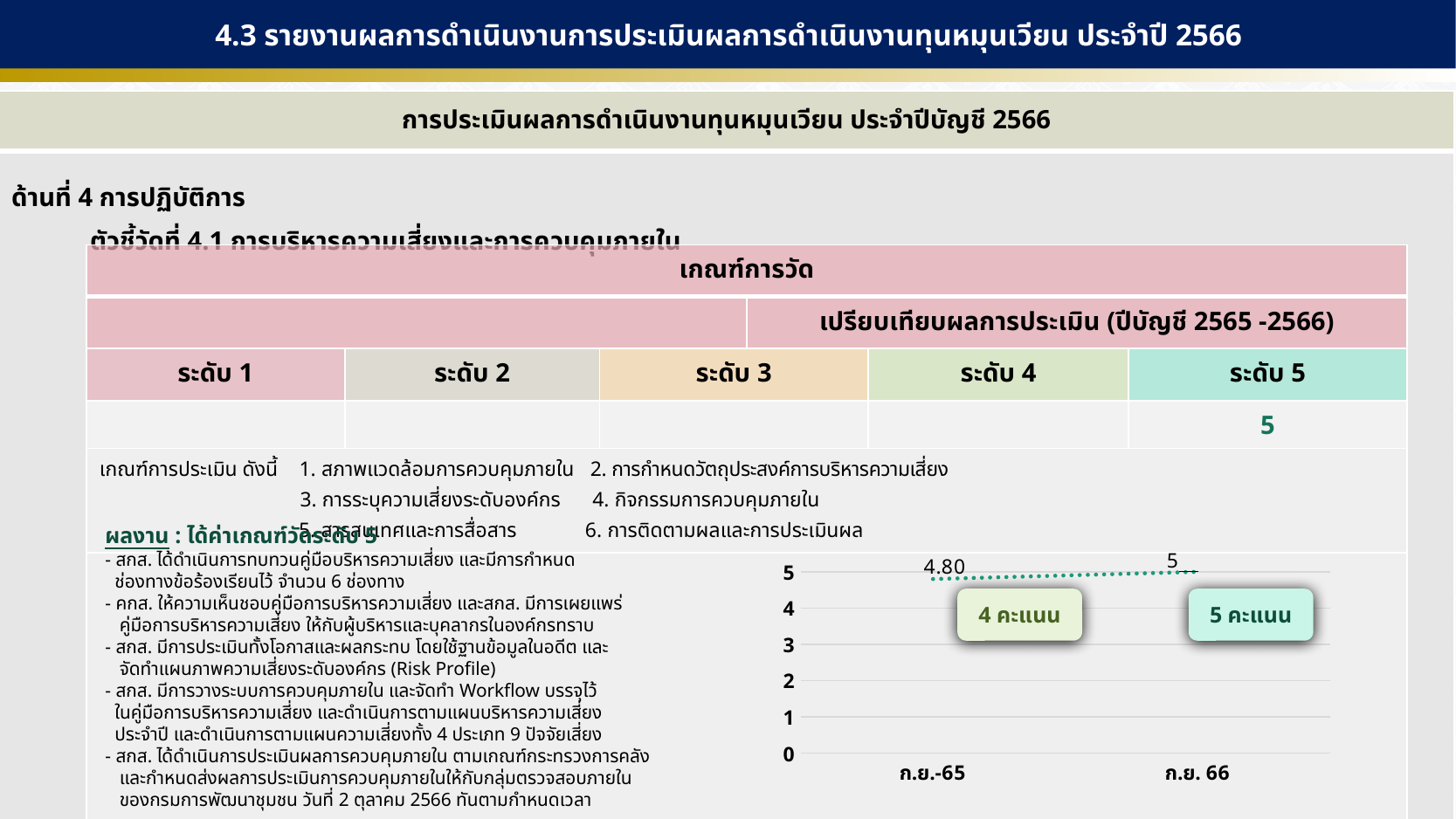
What is the difference between the values for ก.ย. 66 and ก.ย.-65? 0.20 Is the value for ก.ย.-65 greater or less than 4? greater What is the value plotted for ก.ย.-65? 4.80 What score is shown in the callout box above ก.ย. 66? 5 คะแนน What is the highest value shown on the chart's vertical axis? 5 What is the value plotted for ก.ย. 66? 5 Do the values rise or fall from ก.ย.-65 to ก.ย. 66? rise Which category has the lower value on the chart? ก.ย.-65 What kind of chart is shown on the slide? line chart How many data points are plotted on the chart? 2 Which category has the higher value, ก.ย.-65 or ก.ย. 66? ก.ย. 66